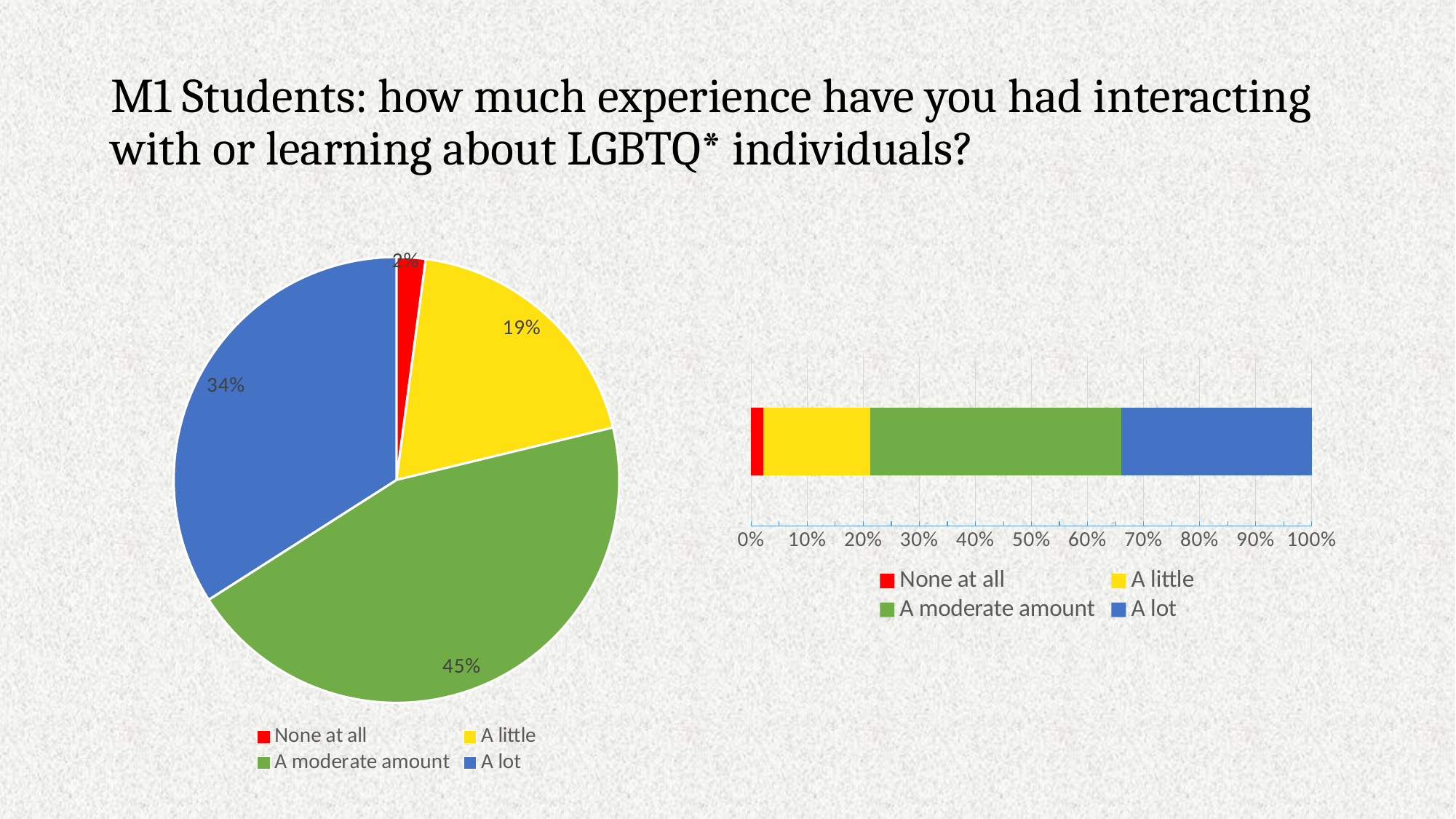
In the pie chart on the left, what is the difference in percentage points between "A moderate amount" and "A lot"? 11 In the pie chart on the left, what share of M1 students answered "A little"? 19% How many entries does the legend of the chart on the right list? 4 In the pie chart on the left, what share of M1 students answered "A moderate amount"? 45% In the chart on the right, which colour represents "A moderate amount"? Green How many slices does the pie chart on the left have? 4 In the pie chart on the left, what share of M1 students answered "None at all"? 2% In the pie chart on the left, what share of M1 students answered "A lot"? 34% What type of chart is shown on the right side of the slide? Stacked bar chart In the pie chart on the left, which response has the smallest slice? None at all In the pie chart on the left, which is larger: the share for "A little" or the share for "A lot"? A lot In the pie chart on the left, which response has the largest slice? A moderate amount